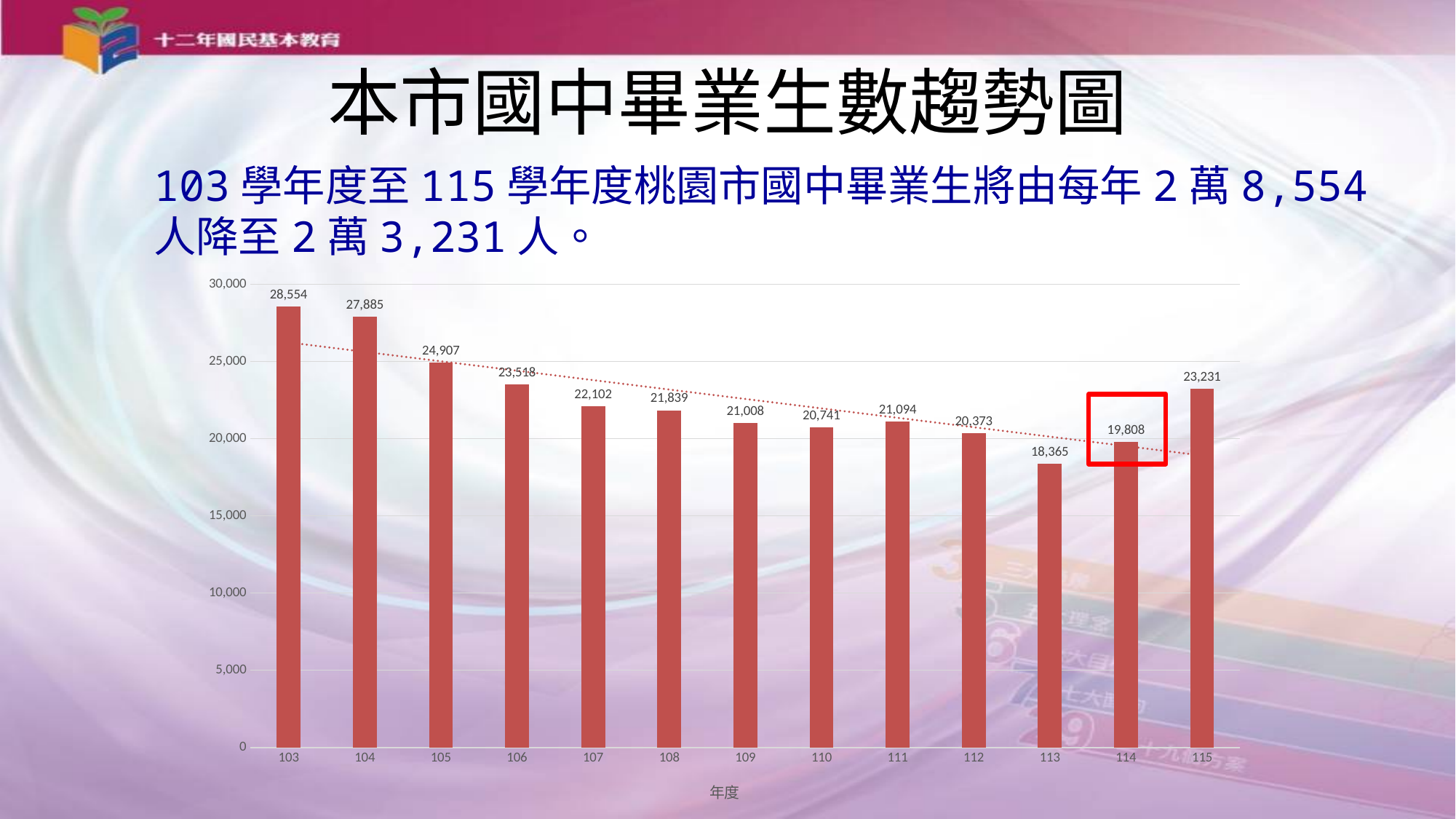
Which is larger, the value for year 111 or the value for year 112? 111 Which year has the lowest value? 113 What is the value for year 109? 21,008 Which year has the highest value? 103 What is the value for year 103? 28,554 Is the value for year 105 greater or less than 25,000? less What kind of chart is shown on the slide? bar chart What is the difference between the values for year 103 and year 115? 5,323 What is the label of the x axis? 年度 How many years are shown on the x axis? 13 What is the difference between the values for year 114 and year 113? 1,443 What is the value for year 114? 19,808